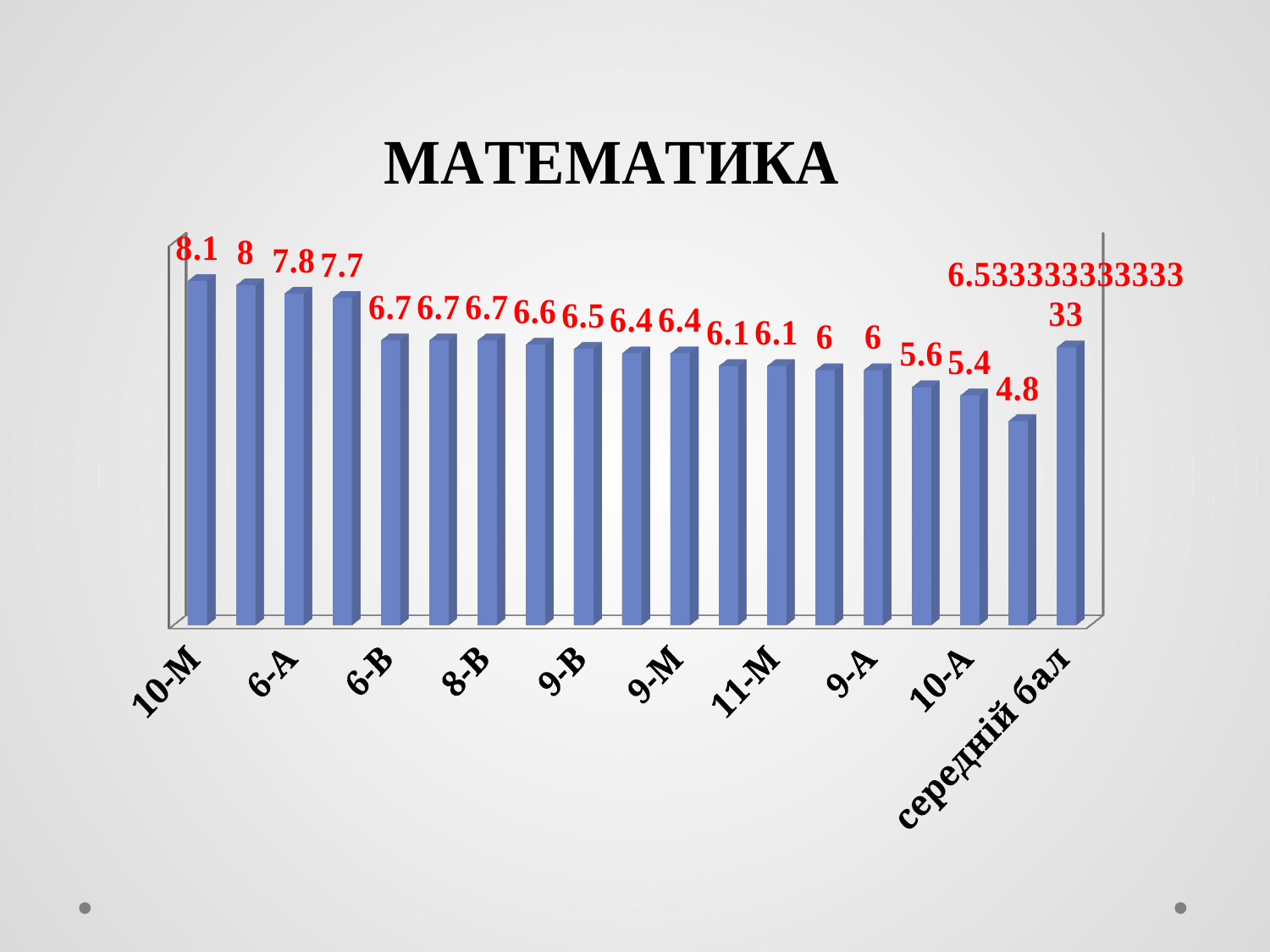
What is the value for середній бал? 6.53333333333333 What type of chart is shown on the slide? bar chart What is the lowest value shown on the chart? 4.8 What is the highest value shown on the chart? 8.1 Which category has the highest value? 10-М How many bars are plotted on the chart? 19 What colour are the bars on the chart? blue Is the value for 10-М larger or smaller than the value for середній бал? larger What is the value for 10-М? 8.1 What is the title of the chart? МАТЕМАТИКА Do the class values generally rise or fall from left to right across the chart (before the final середній бал bar)? fall What is the difference between the highest value (8.1) and the lowest value (4.8)? 3.3